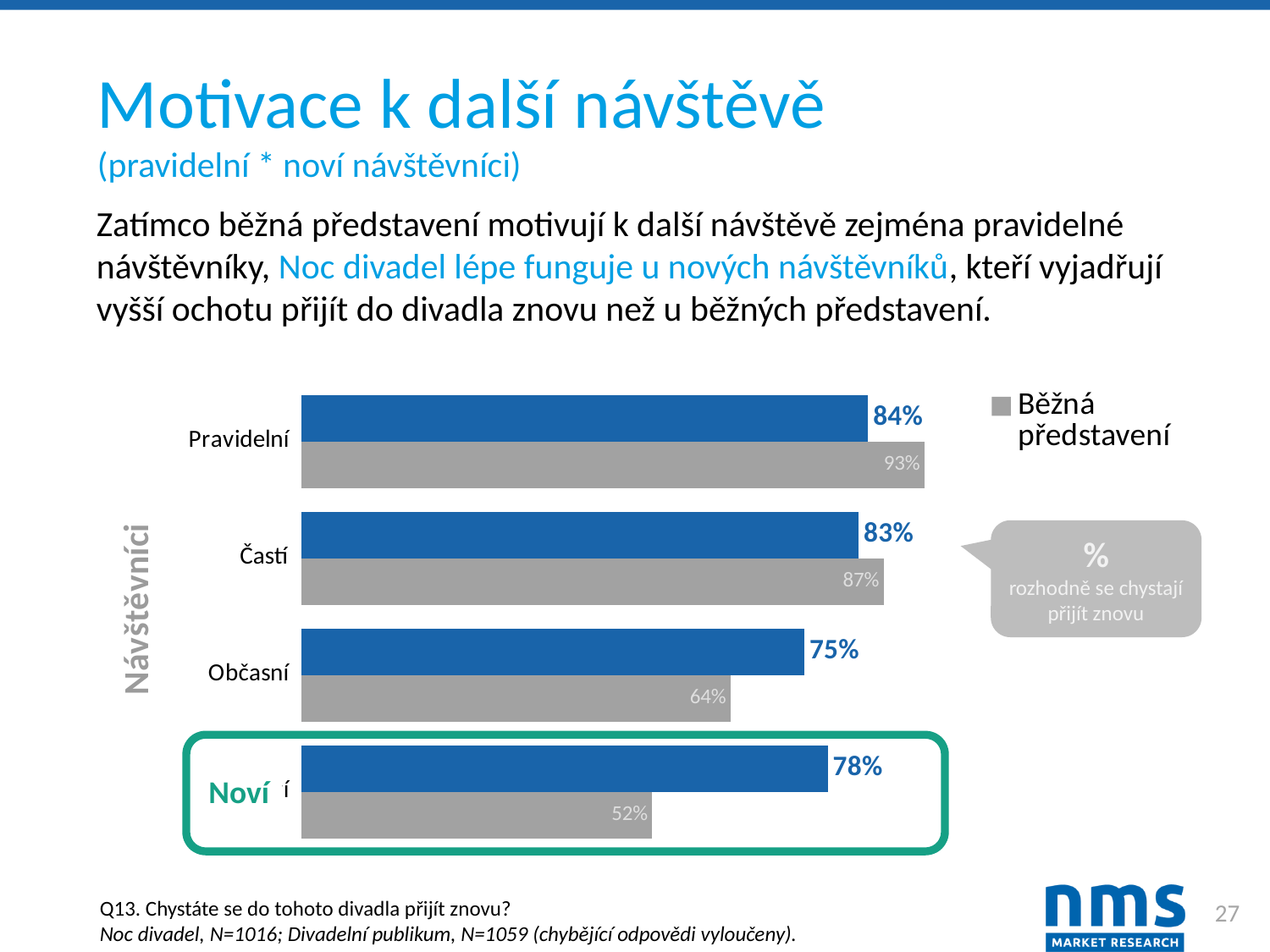
What is the difference between the grey 'Běžná představení' bar and the blue bar for Pravidelní? 9 percentage points For Občasní, which is larger: the blue bar or the grey 'Běžná představení' bar? the blue bar What is the value of the grey 'Běžná představení' bar for Občasní? 64% Which category has the lowest value for the grey 'Běžná představení' series? Noví Which category has the highest value for the blue series? Pravidelní What is the value of the blue bar for Častí? 83% What is the value of the blue bar for Noví? 78% What kind of chart is shown on the slide? bar chart What is the value of the grey 'Běžná představení' bar for Pravidelní? 93% How many visitor categories are shown on the chart? 4 Which category is highlighted with a green outline on the chart? Noví What is the difference between the blue bar and the grey 'Běžná představení' bar for Noví? 26 percentage points